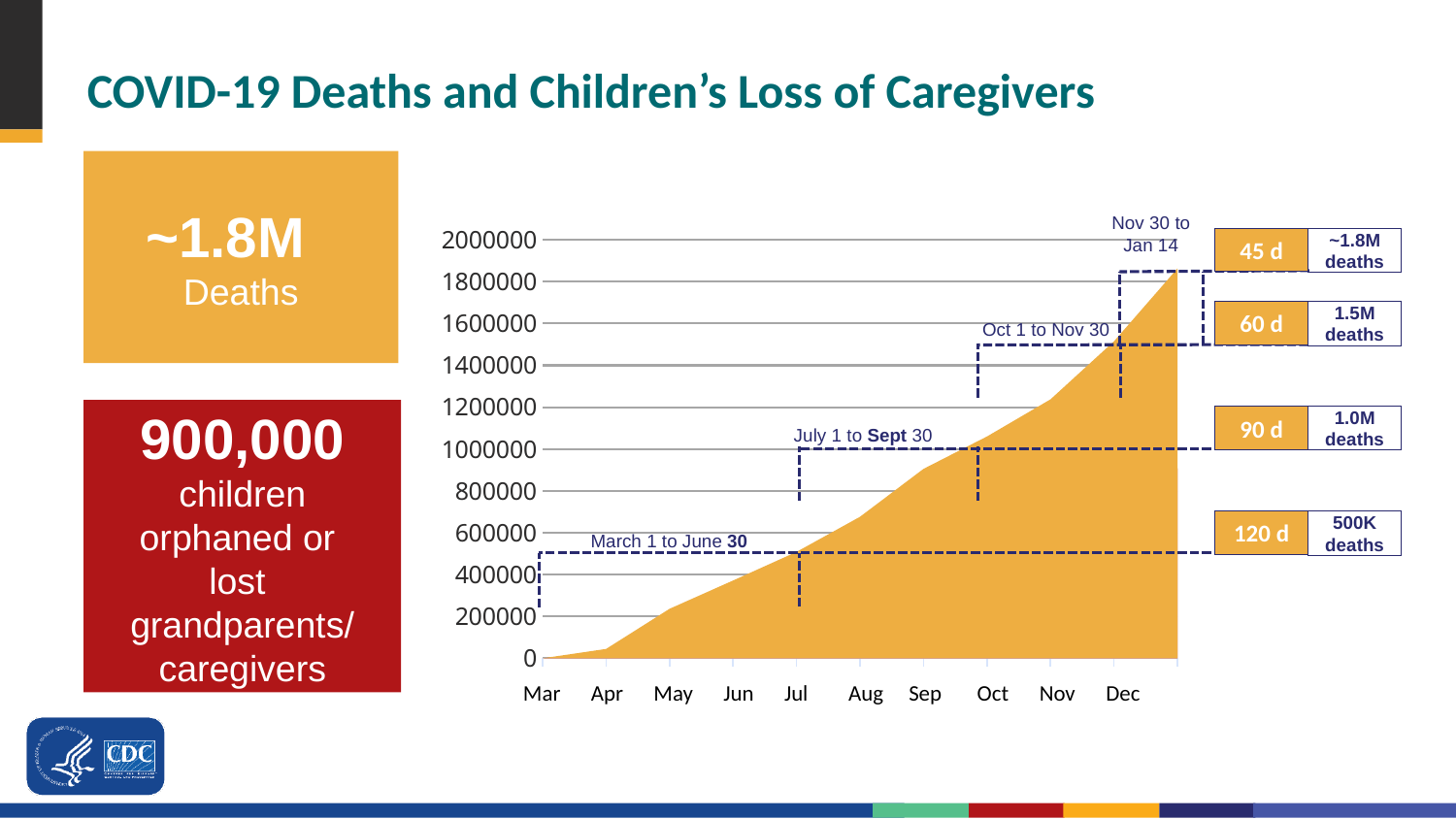
Is the value for Dec greater or less than 1600000? greater Do the values in the chart rise or fall from Mar to Dec? rise What kind of chart is shown on the slide? area chart Which month on the x axis has the highest value in the chart? Dec Is the value for Oct greater or less than 800000? greater According to the annotations on the chart, which date range corresponds to the 1.0M deaths milestone? July 1 to Sept 30 According to the annotations on the chart, how many days did it take to reach 500K deaths? 120 d Which month on the x axis has the lowest value in the chart? Mar How many months are labelled on the x axis of the chart? 10 Is the value for Nov greater or less than 1000000? greater